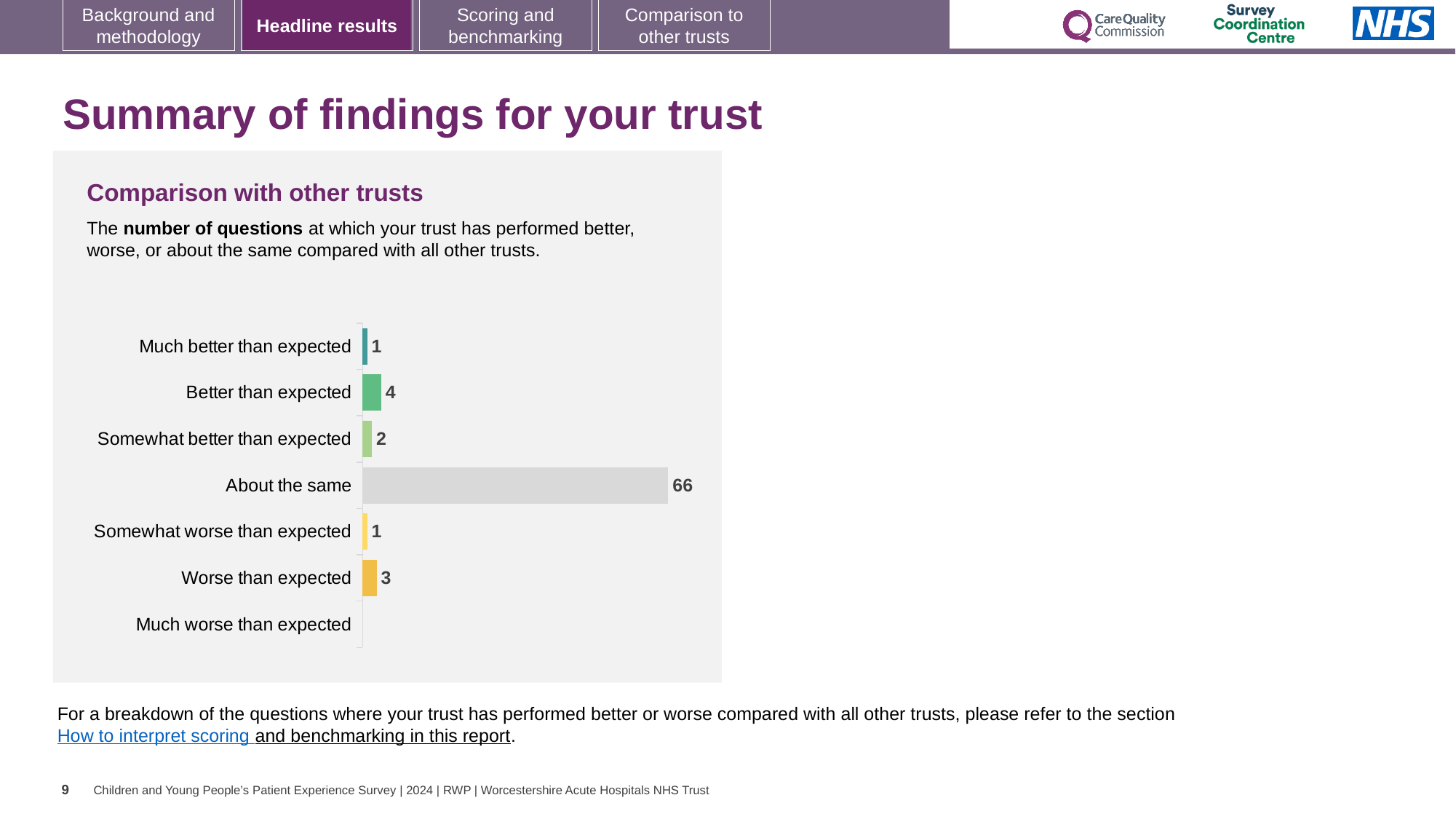
How many categories are listed on the chart? 7 What kind of chart is shown under 'Comparison with other trusts'? bar chart What is the difference between 'About the same' and 'Better than expected'? 62 Which is larger, 'Better than expected' or 'Somewhat better than expected'? Better than expected What is the value for 'Somewhat better than expected'? 2 What is the value for 'Better than expected'? 4 Which category has the highest value? About the same What is the difference between 'Better than expected' and 'Worse than expected'? 1 How many questions were rated 'About the same'? 66 What is the value for 'Worse than expected'? 3 What is the total number of questions across all categories shown? 77 What is the title of the chart? Comparison with other trusts